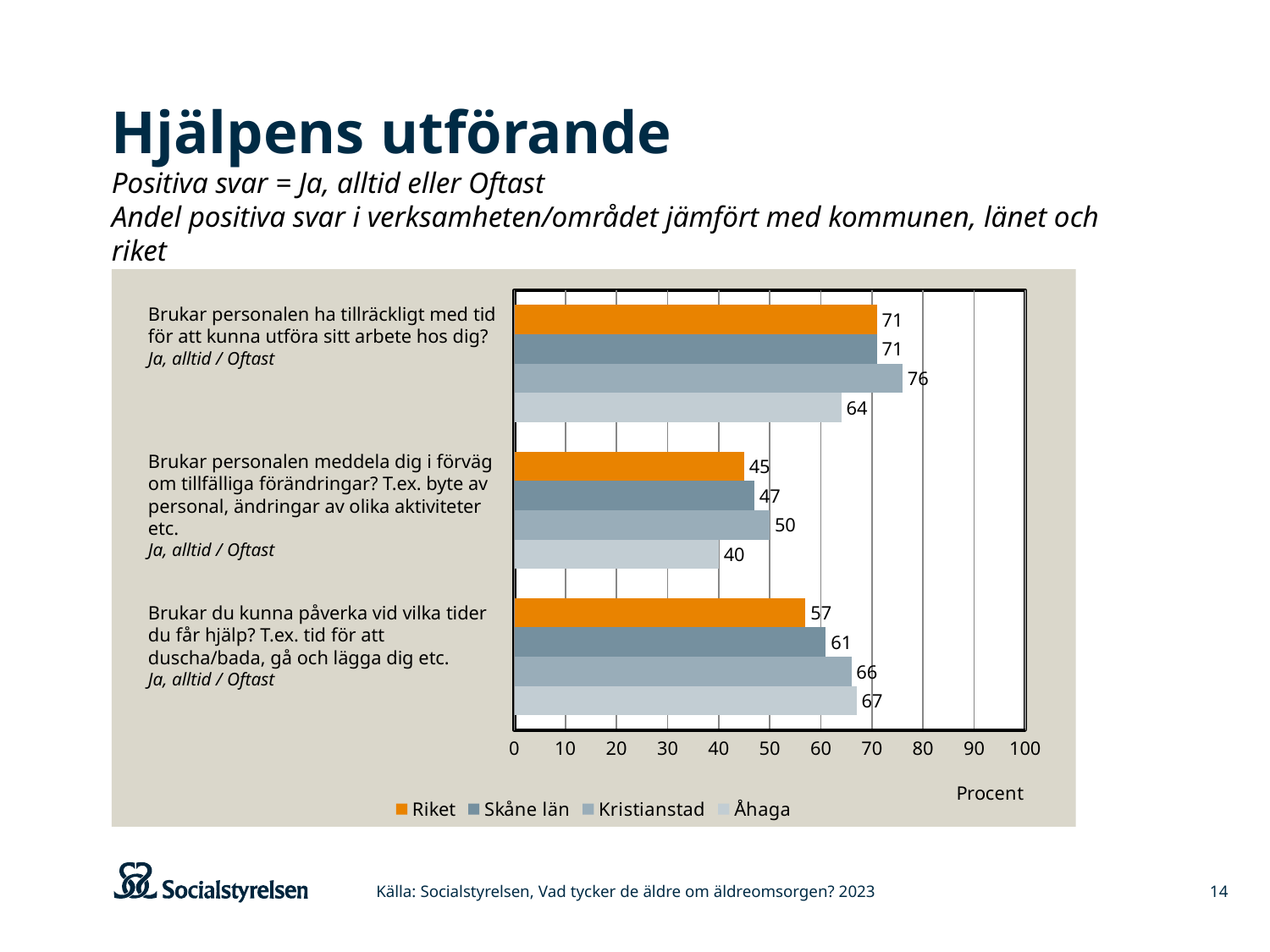
Which series has the highest value on the question "Brukar personalen ha tillräckligt med tid för att kunna utföra sitt arbete hos dig?"? Kristianstad How many series does the legend list? 4 Which series has the lowest value on the question "Brukar personalen meddela dig i förväg om tillfälliga förändringar?"? Åhaga What is the value for Riket on the question "Brukar du kunna påverka vid vilka tider du får hjälp?"? 57 What is the value for Kristianstad on the question "Brukar personalen meddela dig i förväg om tillfälliga förändringar?"? 50 What kind of chart is shown on the slide? Bar chart Is the value for Åhaga on the question "Brukar du kunna påverka vid vilka tider du får hjälp?" greater or less than 60? greater On the question "Brukar personalen meddela dig i förväg om tillfälliga förändringar?", which is larger: Riket or Kristianstad? Kristianstad What is the difference between Kristianstad and Åhaga on the question "Brukar personalen ha tillräckligt med tid för att kunna utföra sitt arbete hos dig?"? 12 What is the difference between Skåne län and Riket on the question "Brukar du kunna påverka vid vilka tider du får hjälp?"? 4 How many questions (categories) are shown in the chart? 3 What is the value for Åhaga on the question "Brukar personalen ha tillräckligt med tid för att kunna utföra sitt arbete hos dig?"? 64